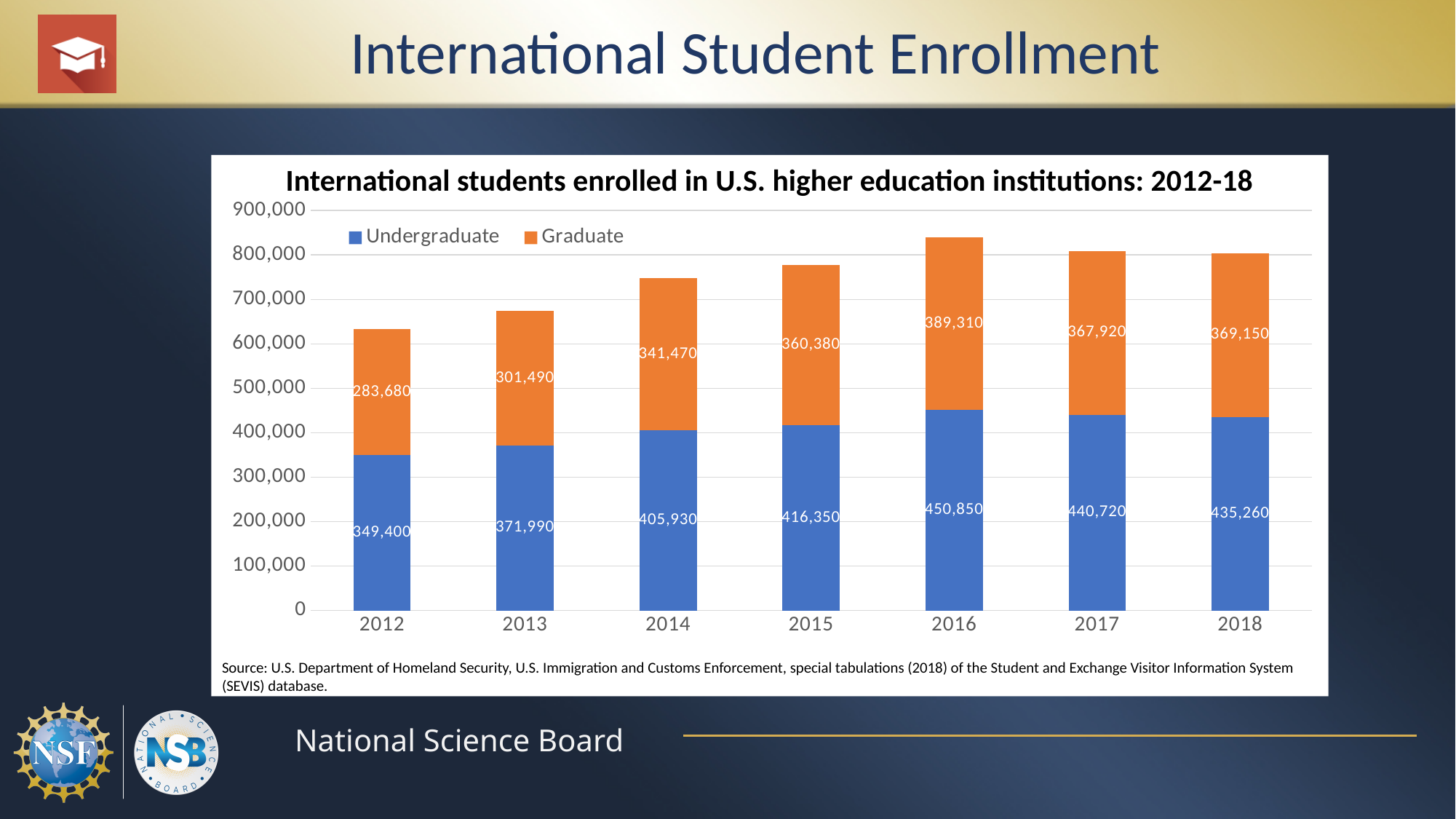
Which year has the lowest Graduate value? 2012 Which is larger, the Undergraduate value for 2014 or the Undergraduate value for 2013? 2014 What is the Undergraduate value for 2016? 450,850 What is the Graduate value for 2012? 283,680 What is the Graduate value for 2018? 369,150 How many series does the legend list? 2 What is the difference between the Undergraduate values for 2016 and 2012? 101,450 What is the total of the stacked bar for 2016? 840,160 What is the total of the stacked bar for 2012? 633,080 How many years are shown on the x axis? 7 Which year has the highest Undergraduate value? 2016 What kind of chart is shown on the slide? Stacked bar chart